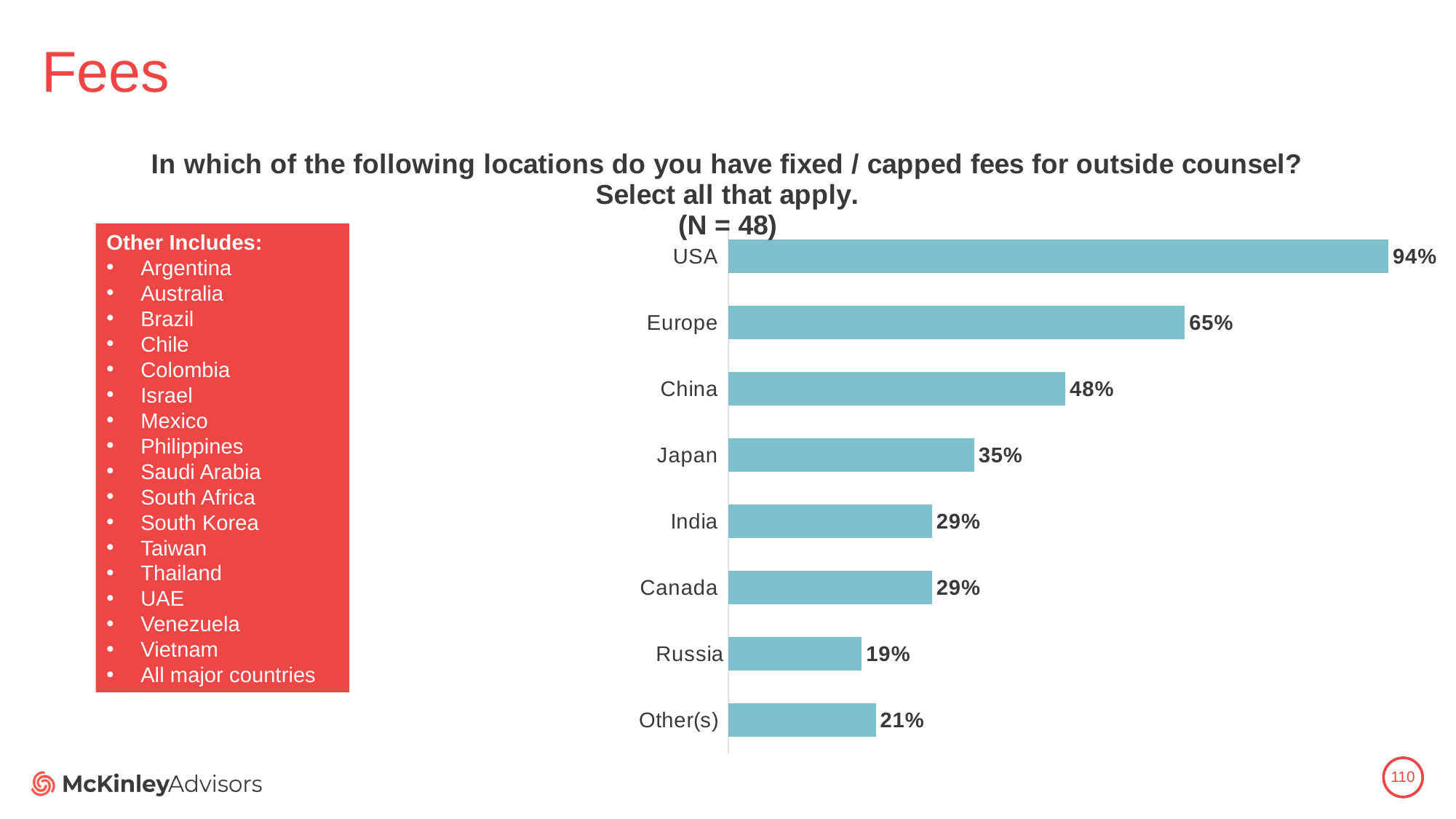
What percentage of respondents have fixed / capped fees for outside counsel in the USA? 94% What is the value shown for Japan? 35% What is the value shown for Europe? 65% Which location has the highest percentage? USA Which has a higher value, Other(s) or Russia? Other(s) What kind of chart is shown on the slide? Bar chart What is the value shown for Russia? 19% What is the difference in percentage points between China and Japan? 13 What is the sample size (N) stated in the chart title? 48 What is the difference in percentage points between the USA and Europe? 29 How many locations are shown in the chart? 8 Which location has the lowest percentage? Russia